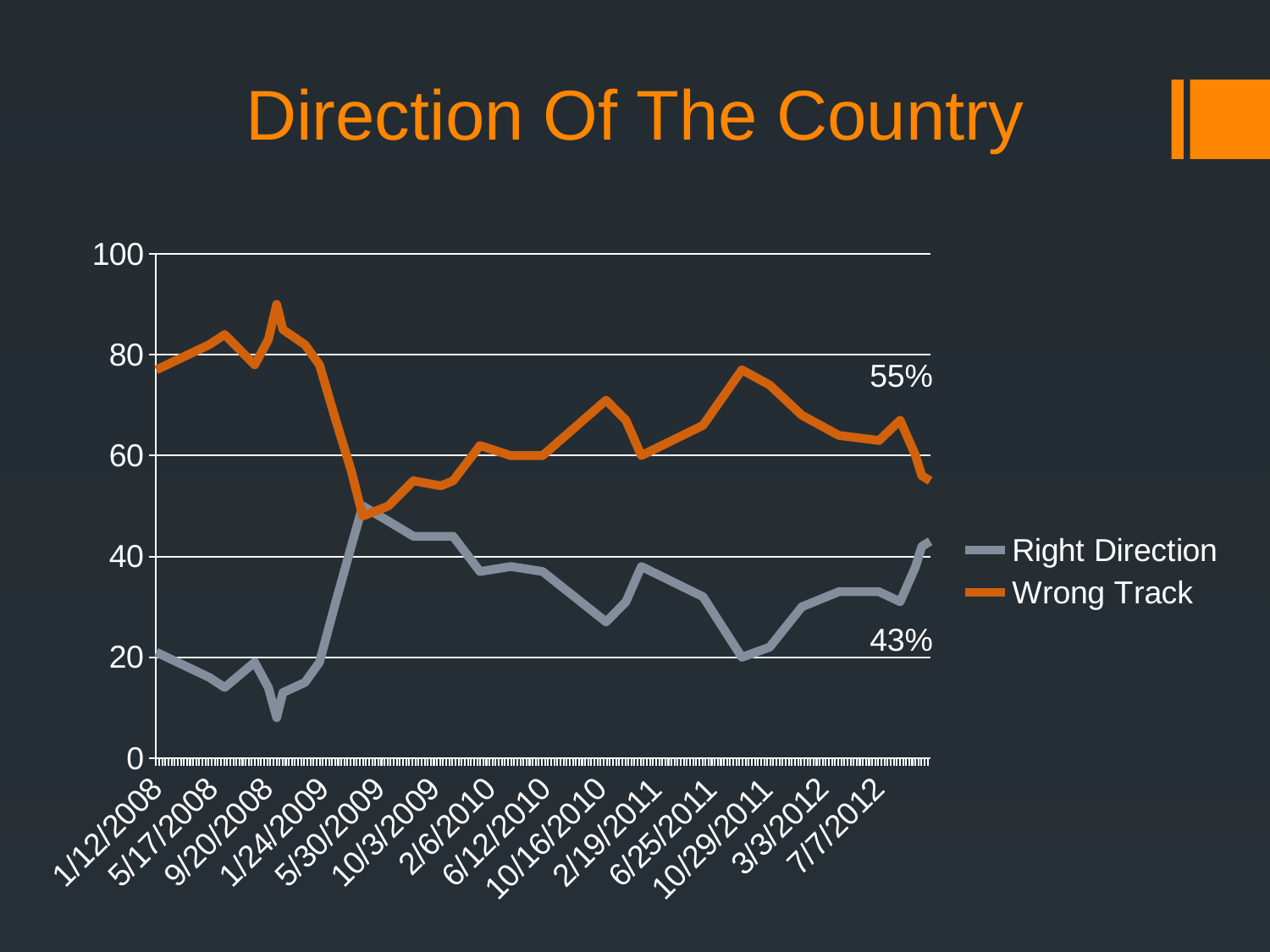
How many date labels are shown along the x axis? 14 What is the final labelled value for the Wrong Track series? 55% Is the Wrong Track value at 1/12/2008 greater or less than 60? greater What is the difference between the final labelled Wrong Track value (55%) and the final labelled Right Direction value (43%)? 12 percentage points What is the title of the chart? Direction Of The Country Is the Right Direction value at 1/12/2008 greater or less than 40? less How many series does the legend list? 2 At the end of the chart, which series has the larger value, Right Direction or Wrong Track? Wrong Track What is the final labelled value for the Right Direction series? 43% What kind of chart is shown on the slide? line chart Is the Right Direction value at 10/29/2011 greater or less than 40? less Does the Wrong Track line rise or fall between 1/24/2009 and 5/30/2009? fall